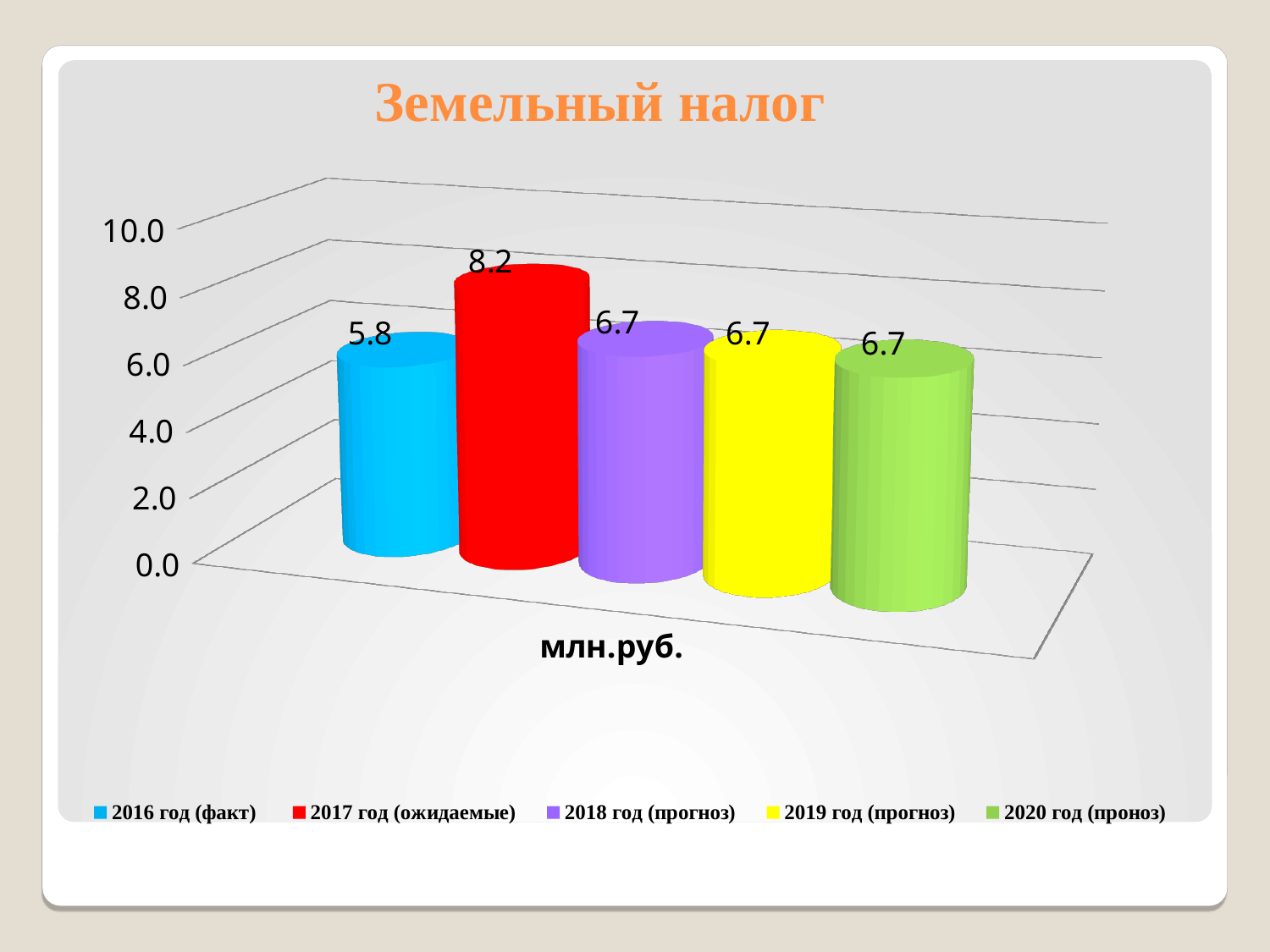
What kind of chart is shown on the slide? bar chart What is the title of the chart? Земельный налог What is the difference between the values for 2017 год (ожидаемые) and 2018 год (прогноз)? 1.5 What is the value for 2016 год (факт)? 5.8 What is the value for 2017 год (ожидаемые)? 8.2 Which series has the highest value? 2017 год (ожидаемые) Which is larger, the value for 2016 год (факт) or the value for 2020 год (проноз)? 2020 год (проноз) Which series has the lowest value? 2016 год (факт) What is the difference between the values for 2017 год (ожидаемые) and 2016 год (факт)? 2.4 What is the value for 2019 год (прогноз)? 6.7 Is the value for 2017 год (ожидаемые) greater or less than 8.0? greater How many series does the legend list? 5